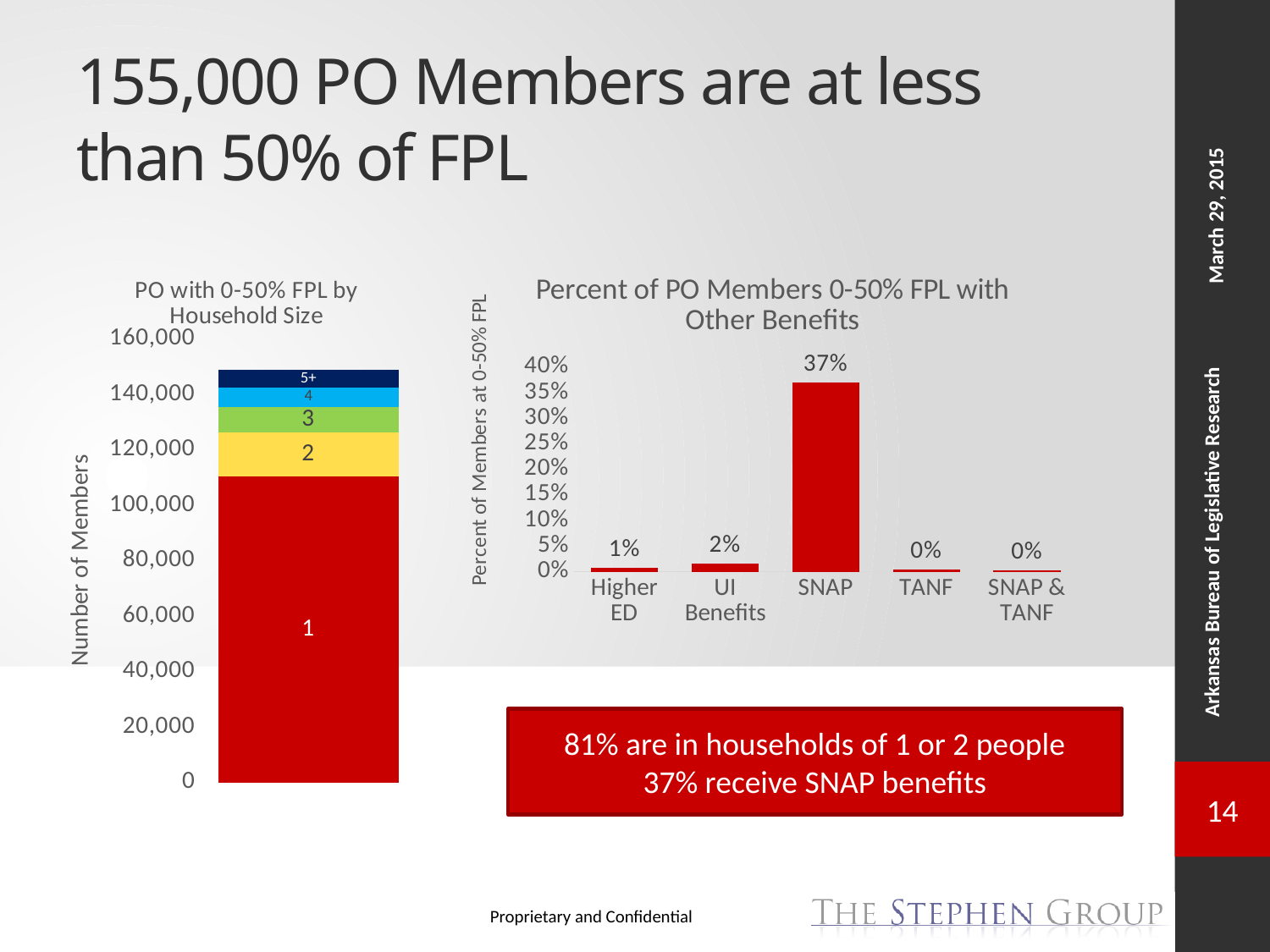
In the chart 'PO with 0-50% FPL by Household Size', what is the y-axis title? Number of Members In the chart 'Percent of PO Members 0-50% FPL with Other Benefits', what is the value for SNAP? 37% In the chart 'Percent of PO Members 0-50% FPL with Other Benefits', what is the value for Higher ED? 1% In the chart 'Percent of PO Members 0-50% FPL with Other Benefits', which is larger, Higher ED or UI Benefits? UI Benefits In the chart 'PO with 0-50% FPL by Household Size', how many household-size segments make up the stacked bar? 5 In the chart 'Percent of PO Members 0-50% FPL with Other Benefits', which category has the highest value? SNAP In the chart 'PO with 0-50% FPL by Household Size', is the value for household size 1 greater or less than 100,000? greater In the chart 'Percent of PO Members 0-50% FPL with Other Benefits', what is the value for UI Benefits? 2% In the chart 'Percent of PO Members 0-50% FPL with Other Benefits', what is the value for TANF? 0% What kind of chart is 'Percent of PO Members 0-50% FPL with Other Benefits'? Bar chart In the chart 'Percent of PO Members 0-50% FPL with Other Benefits', how many categories are shown on the x axis? 5 In the chart 'Percent of PO Members 0-50% FPL with Other Benefits', what is the difference between the SNAP value and the UI Benefits value? 35%